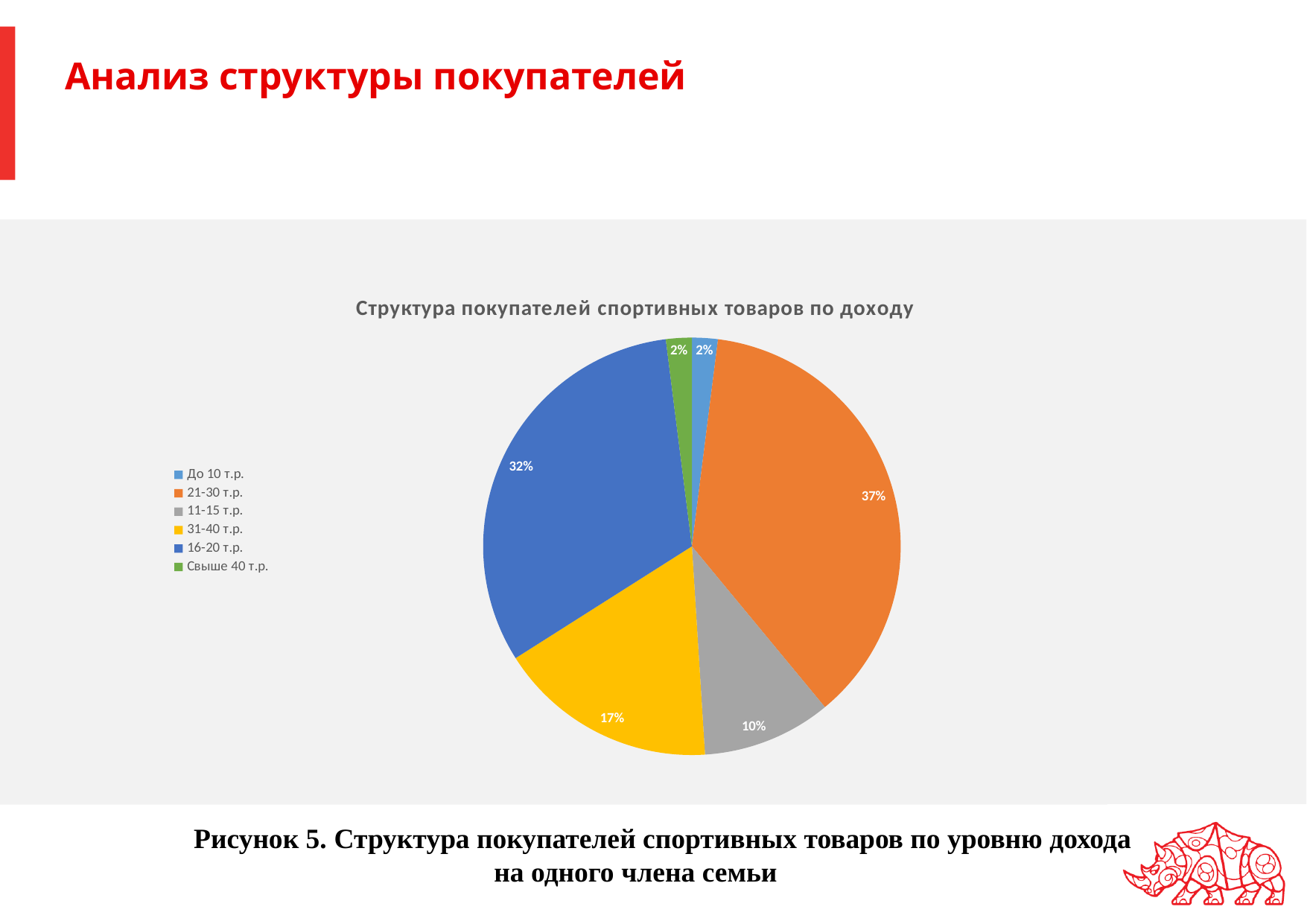
How many categories does the legend of the pie chart list? 6 What is the title of the chart? Структура покупателей спортивных товаров по доходу What is the difference in percentage points between the 21-30 т.р. share and the 16-20 т.р. share? 5% What kind of chart is shown on the slide? Pie chart Which income category has the largest share of the pie? 21-30 т.р. What share of the pie does the 11-15 т.р. category have? 10% What share of the pie does the 16-20 т.р. category have? 32% What share of the pie does the 21-30 т.р. category have? 37% What colour is the slice for the 31-40 т.р. category? Yellow Which is larger, the share for 31-40 т.р. or the share for 11-15 т.р.? 31-40 т.р.